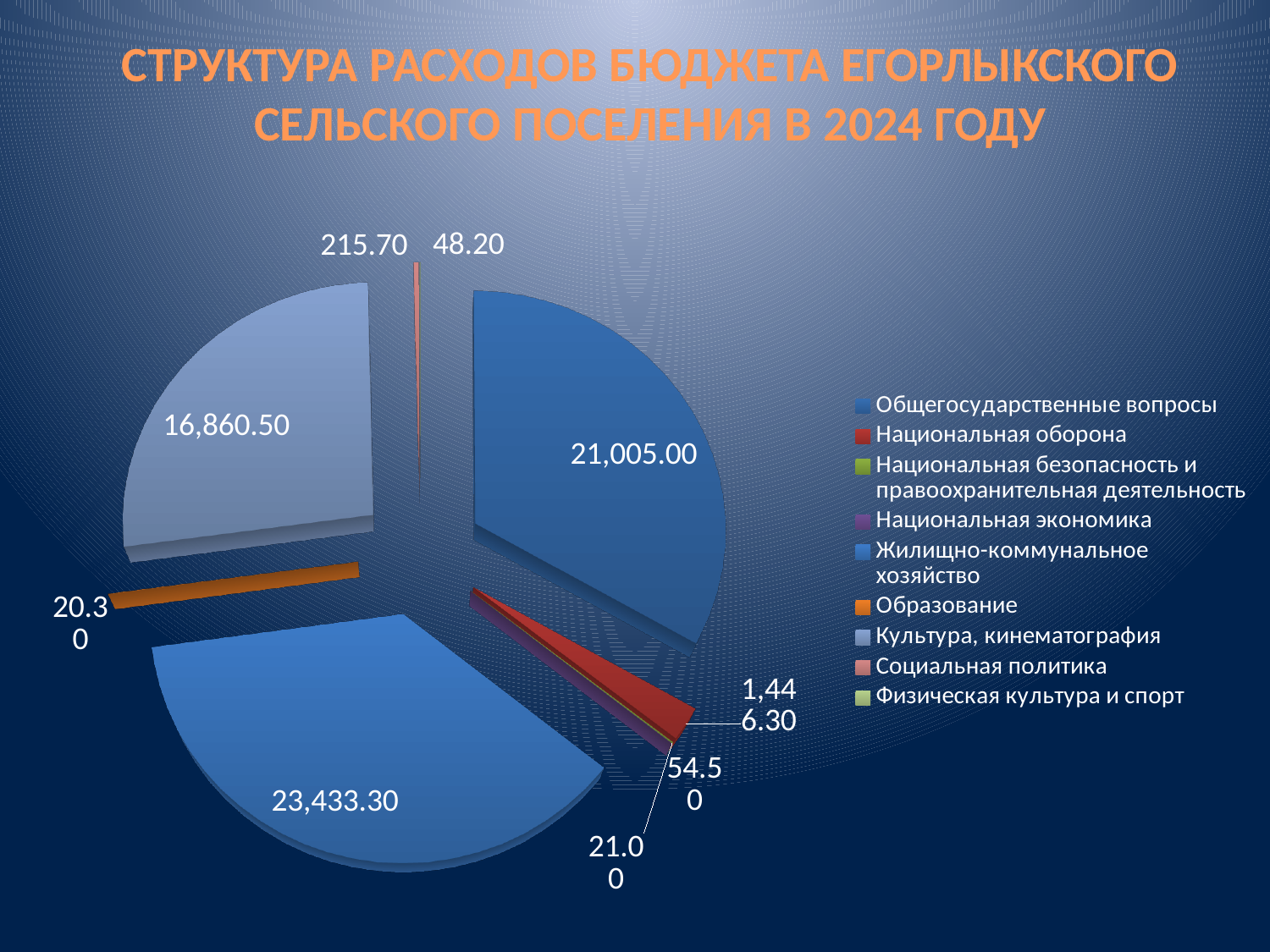
Which category has the smallest value? Образование What is the value for Социальная политика? 215.70 What year does the chart title refer to? 2024 What type of chart is shown on the slide? Pie chart How many categories does the legend list? 9 What is the value for Жилищно-коммунальное хозяйство? 23,433.30 What is the difference between the values for Жилищно-коммунальное хозяйство and Общегосударственные вопросы? 2,428.30 What is the value for Общегосударственные вопросы? 21,005.00 What is the value for Национальная оборона? 1,446.30 Which category has the largest slice of the pie? Жилищно-коммунальное хозяйство Which is larger: the value for Общегосударственные вопросы or for Культура, кинематография? Общегосударственные вопросы What is the value for Культура, кинематография? 16,860.50